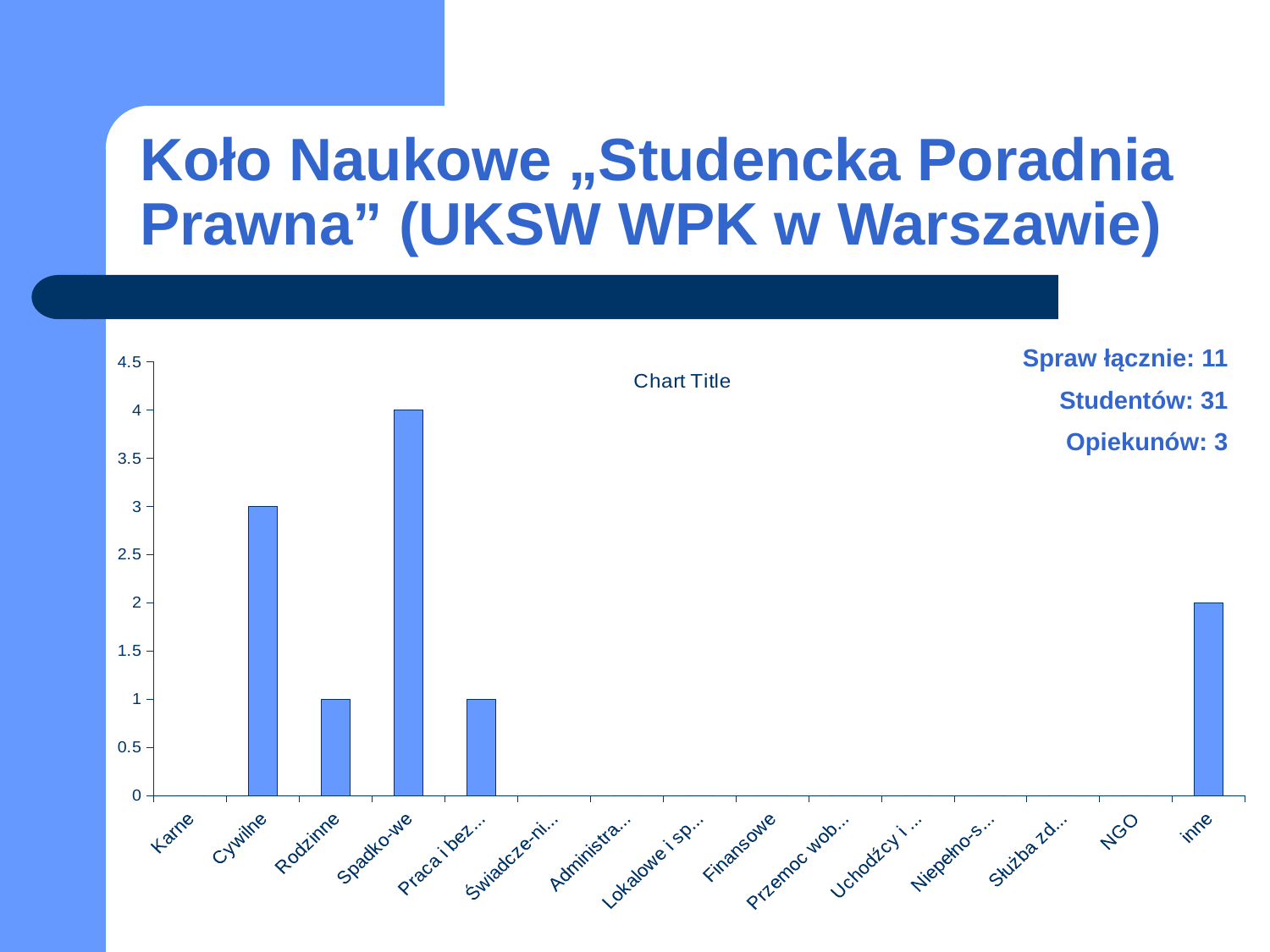
What is the value for Rodzinne? 1 Which is larger, the value for Cywilne or the value for inne? Cywilne What kind of chart is shown on the slide? bar chart Is the value for Spadko-we greater or less than 3.5? greater What is the title of the chart? Chart Title What is the difference between the values for Spadko-we and Cywilne? 1 What is the value for Karne? 0 What is the value for Cywilne? 3 Which category has the highest value? Spadko-we What is the value for inne? 2 How many categories are shown on the x axis? 15 What is the value for Spadko-we? 4